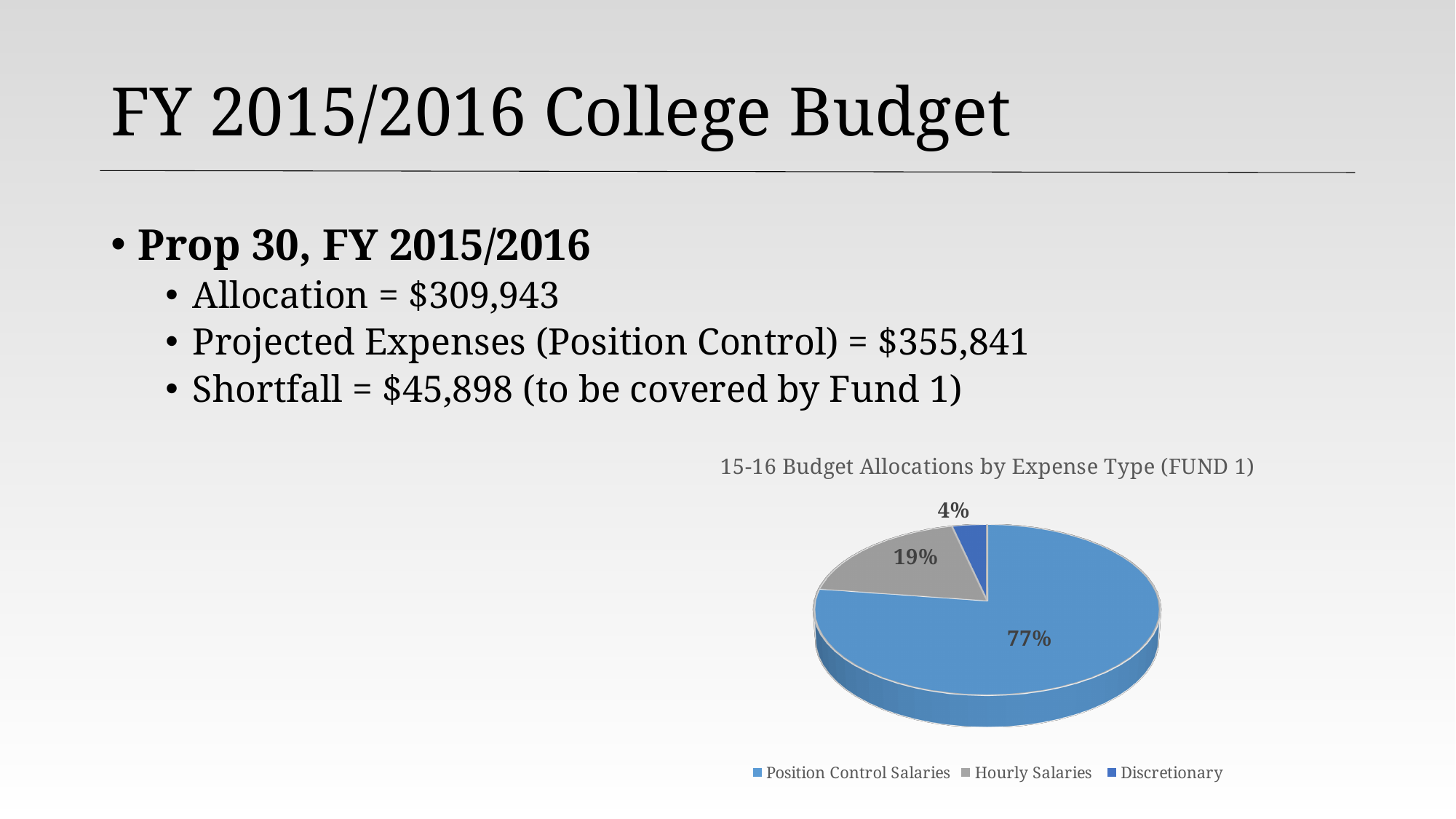
What is the title of the chart? 15-16 Budget Allocations by Expense Type (FUND 1) What share of the pie is Position Control Salaries? 77% What share of the pie is Hourly Salaries? 19% Which expense type has the smallest share of the pie? Discretionary How many entries does the legend list? 3 What share of the pie is Discretionary? 4% Which expense type has the largest share of the pie? Position Control Salaries What type of chart is shown on the slide? Pie chart What is the difference in percentage points between Position Control Salaries and Hourly Salaries? 58 What colour is the Hourly Salaries slice? Grey How many categories does the pie chart show? 3 Which is larger, the share for Hourly Salaries or the share for Discretionary? Hourly Salaries